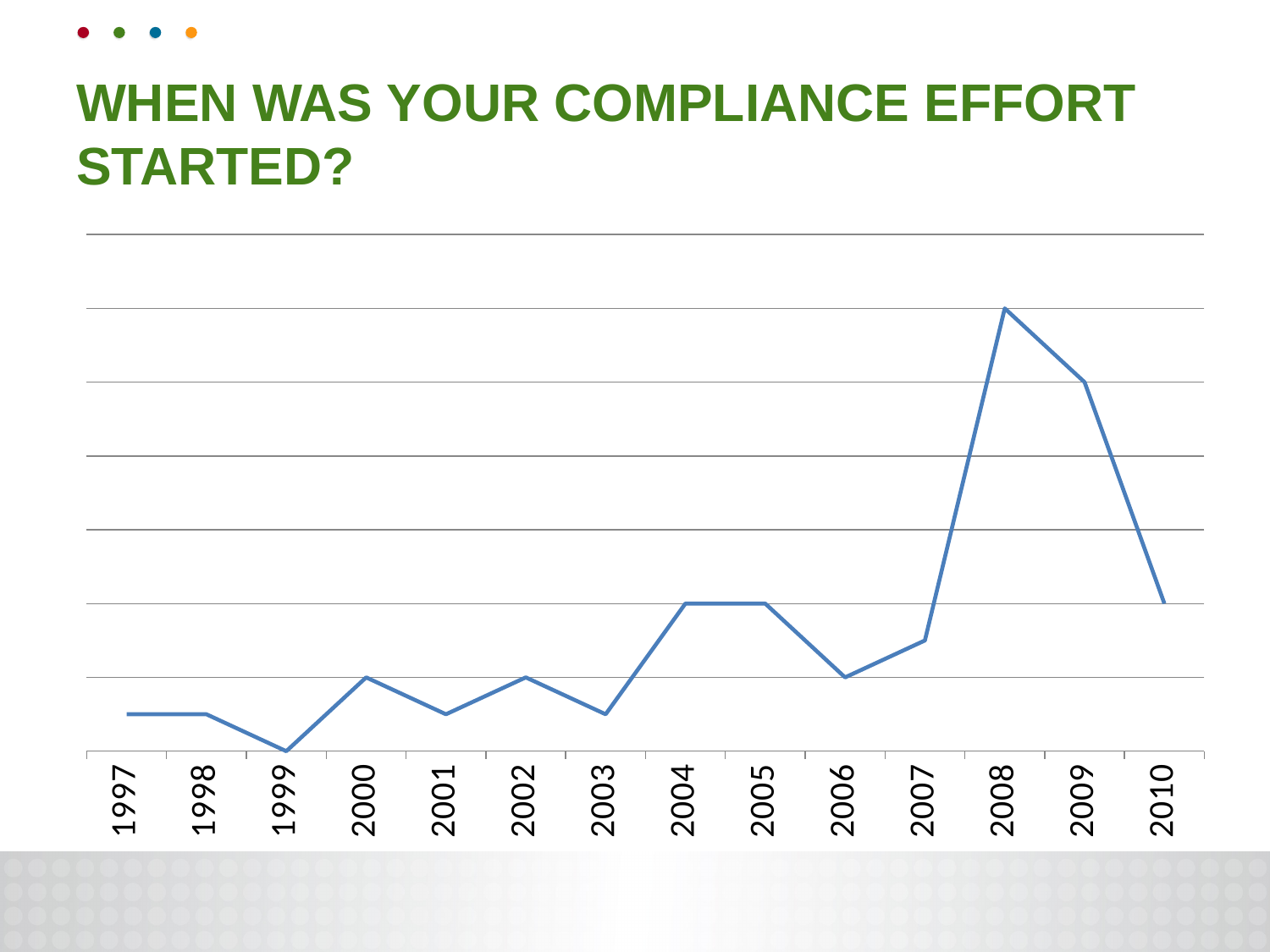
Do the values rise or fall from 2006 to 2008? Rise Which year has the larger value, 2003 or 2004? 2004 How many years are shown along the x axis of the chart? 14 Which year has the lowest value in the chart? 1999 What kind of chart is shown on the slide? Line chart What is the title of the slide containing the chart? WHEN WAS YOUR COMPLIANCE EFFORT STARTED? Do the values rise or fall from 2008 to 2010? Fall Which year has the highest value in the chart? 2008 Which year has the larger value, 2008 or 2009? 2008 What is the first year shown on the x axis of the chart? 1997 Which year has the larger value, 2000 or 2001? 2000